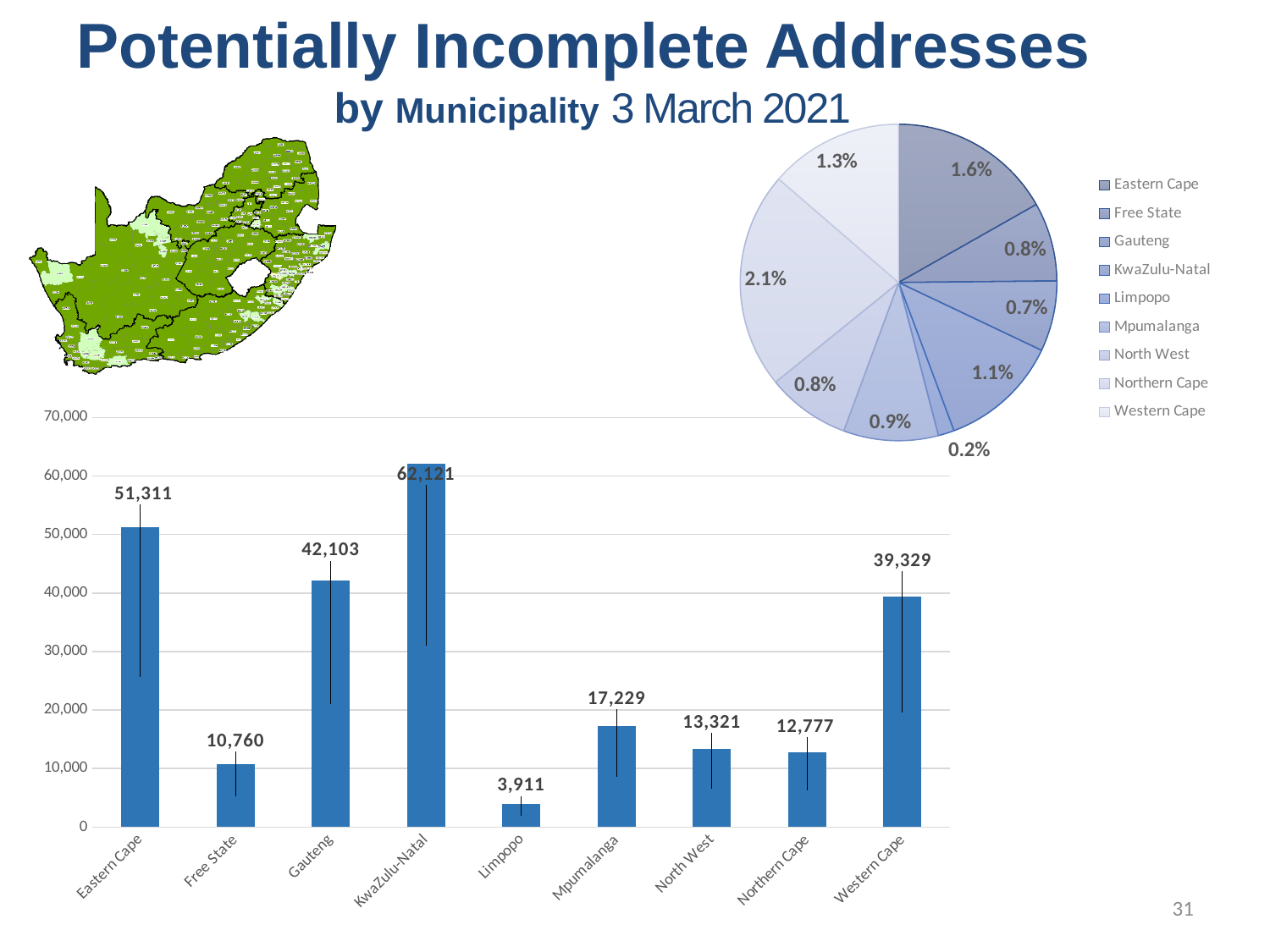
In the bar chart, which province has the highest value? KwaZulu-Natal In the pie chart, what is the largest percentage label shown? 2.1% What kind of chart is the chart at the bottom of the slide? bar chart In the bar chart, what is the value for Limpopo? 3,911 In the bar chart, what is the value for Western Cape? 39,329 In the bar chart, what is the difference between the values for Eastern Cape and Gauteng? 9,208 In the bar chart, is the value for Free State greater or less than 20,000? less How many entries does the pie chart legend list? 9 In the bar chart, which province has the lowest value? Limpopo How many provinces are shown in the bar chart? 9 In the bar chart, what is the value for KwaZulu-Natal? 62,121 In the bar chart, which is larger, the value for North West or the value for Northern Cape? North West